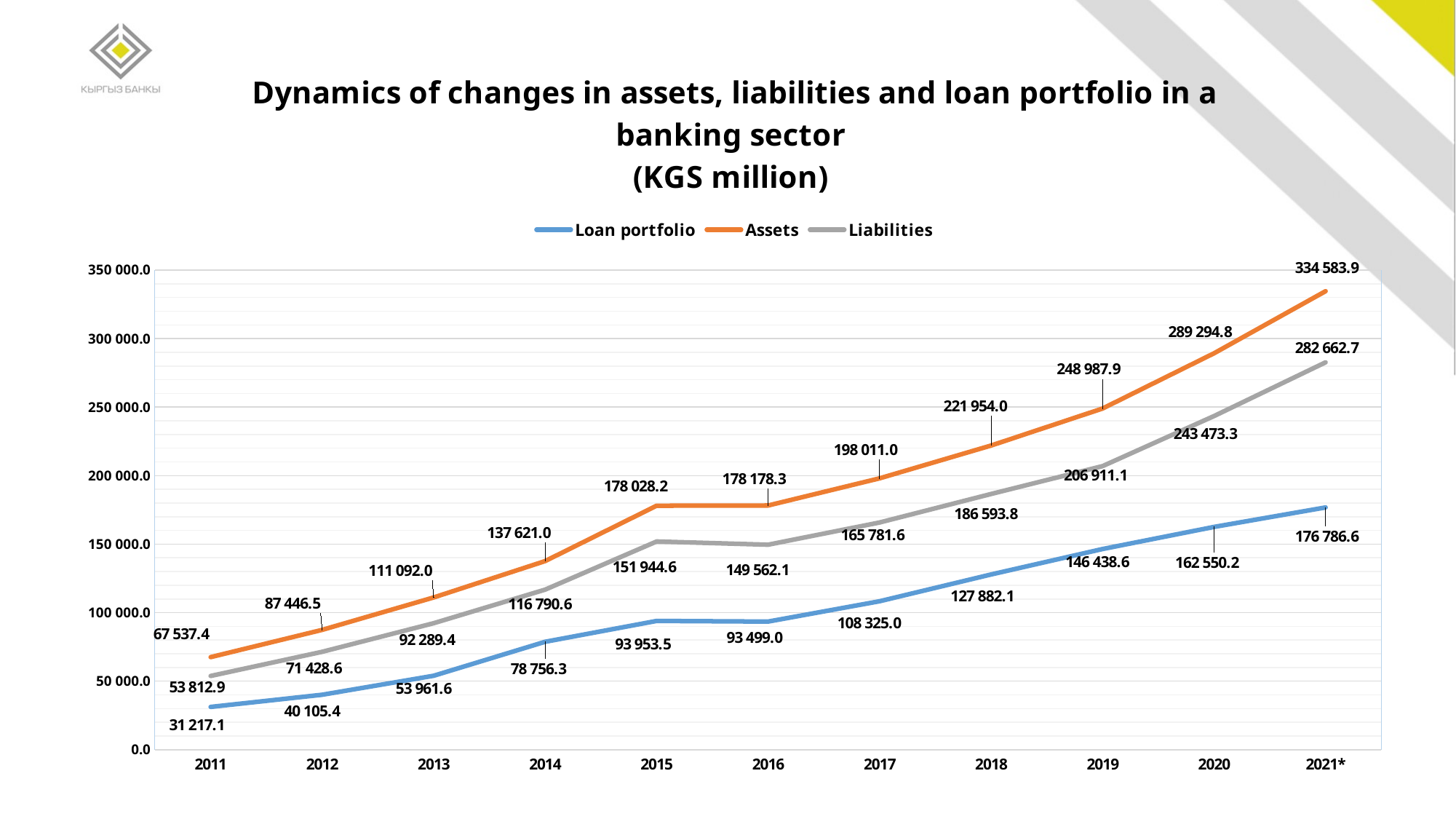
How many years are shown on the x axis? 11 What is the value of Liabilities in 2015? 151 944.6 What is the value of Liabilities in 2018? 186 593.8 How many series does the legend list? 3 What is the value of the Loan portfolio in 2011? 31 217.1 What is the value of Assets in 2021*? 334 583.9 Which is larger in 2014: Assets or Liabilities? Assets What type of chart is shown on the slide? Line chart In which year is the Loan portfolio at its lowest? 2011 By how much did the Loan portfolio increase from 2019 to 2020? 16 111.6 What is the difference between Assets and Liabilities in 2021*? 51 921.2 In which year are Assets at their highest? 2021*